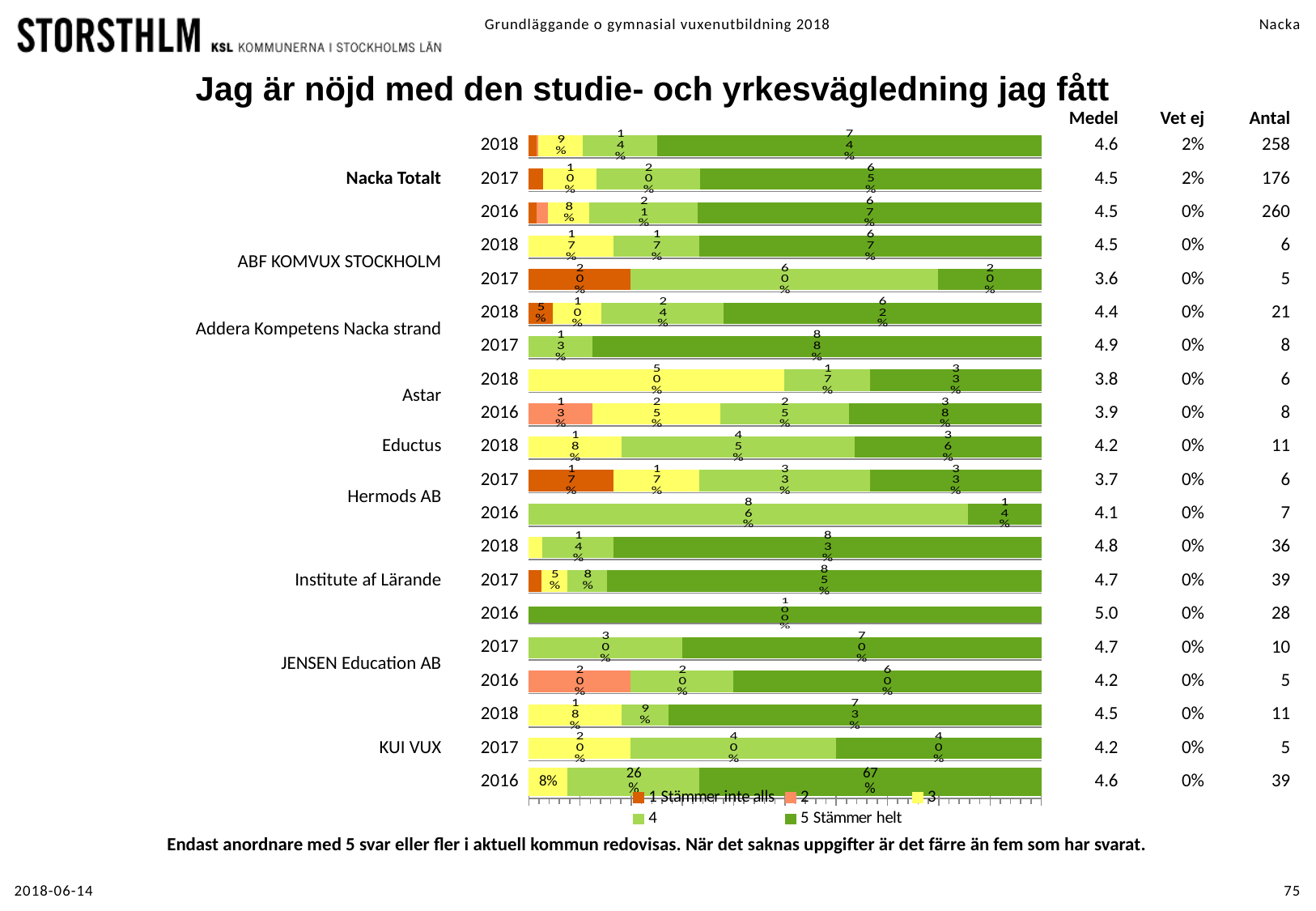
What percentage of Astar respondents in 2018 answered '3'? 50% How many bars are plotted in the chart? 20 What percentage of Addera Kompetens Nacka strand respondents in 2017 answered '5 Stämmer helt'? 88% What percentage of ABF KOMVUX STOCKHOLM respondents in 2017 answered '4'? 60% What percentage of Institute af Lärande respondents in 2016 answered '5 Stämmer helt'? 100% What kind of chart is shown on the slide? bar chart For Nacka Totalt, which year had the larger share of '5 Stämmer helt' answers, 2018 or 2017? 2018 What percentage of Hermods AB respondents in 2016 answered '4'? 86% What is the legend label for the darkest green series? 5 Stämmer helt What percentage of KUI VUX respondents in 2016 answered '5 Stämmer helt'? 67% For Nacka Totalt, what is the difference in percentage points between the '5 Stämmer helt' share in 2018 (74%) and in 2017 (65%)? 9 How many series does the chart legend list? 5